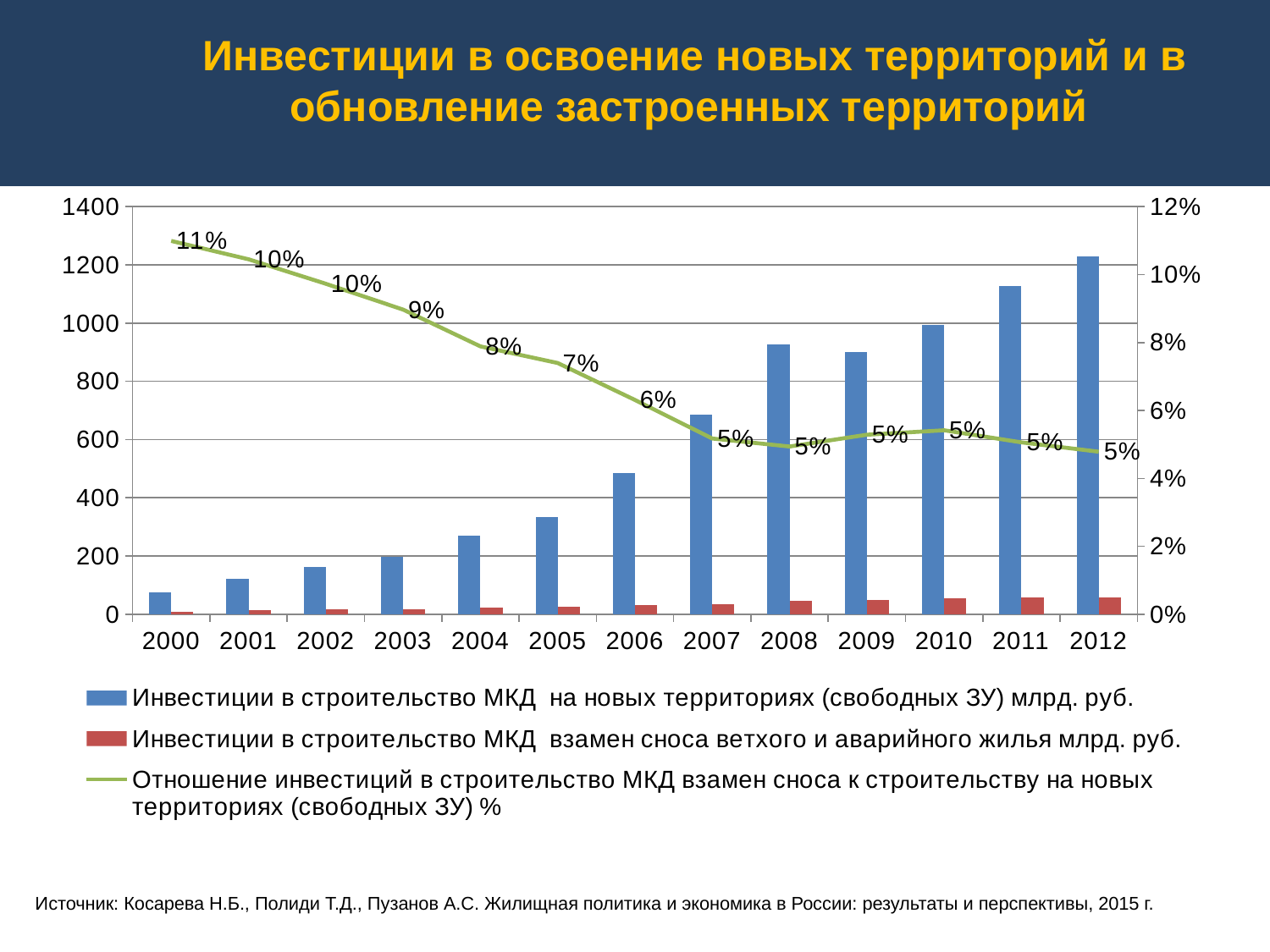
What is the value of the ratio line for 2006? 6% Is the blue bar value for 2006 greater or less than 600? less Does the ratio line rise or fall from 2000 to 2007? fall How many years are shown on the x axis? 13 What is the difference between the ratio line value in 2000 and in 2012? 6% What is the value of the ratio line (Отношение инвестиций...) for 2000? 11% In which year is the blue bar (investment in construction on new territories) lowest? 2000 What is the value of the ratio line for 2004? 8% How many series does the legend list? 3 Which year has a larger blue bar, 2008 or 2009? 2008 In which year is the blue bar (investment in construction on new territories) highest? 2012 Is the blue bar value for 2011 greater or less than 1000? greater